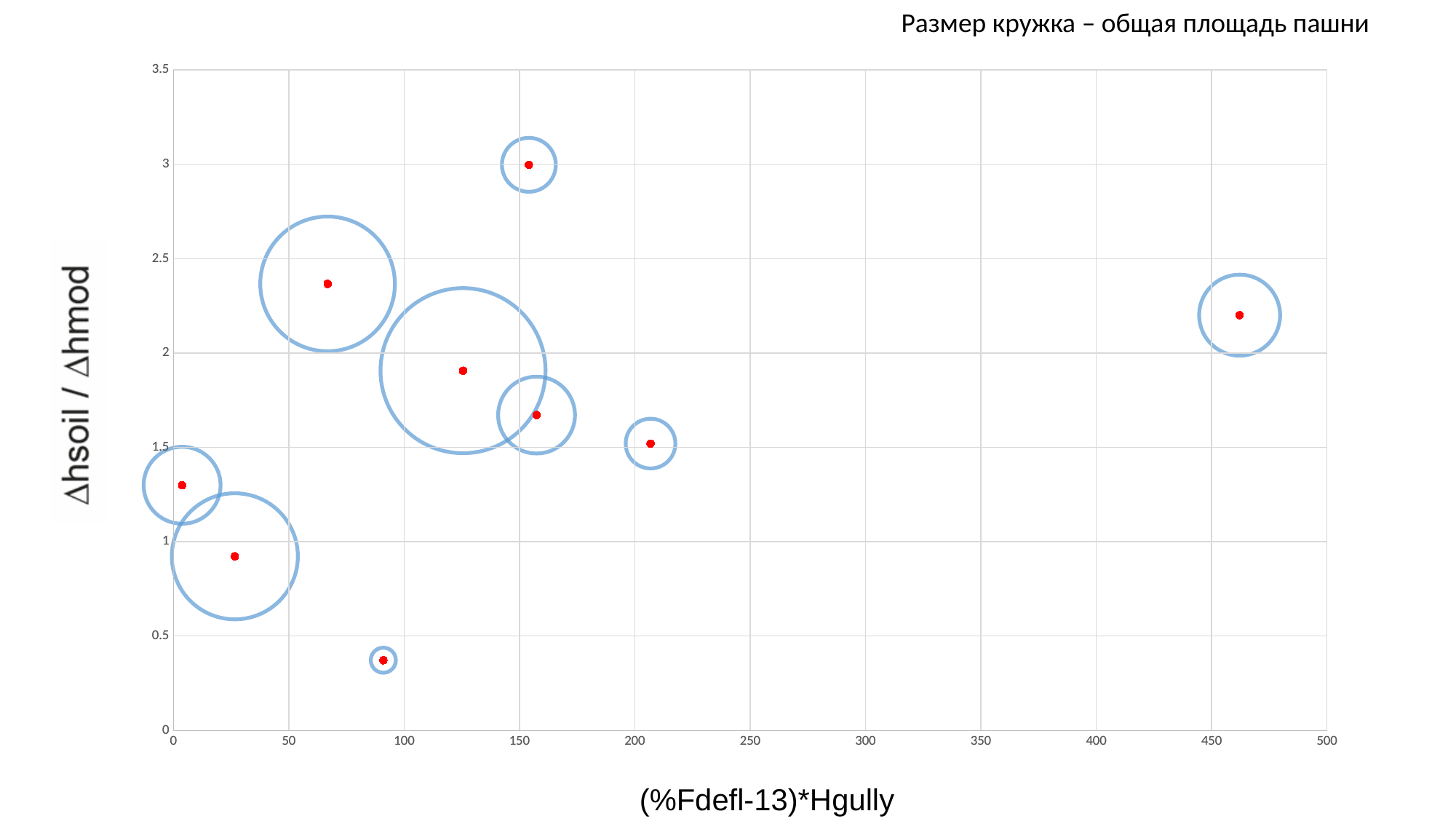
Is the (%Fdefl-13)*Hgully value of the rightmost bubble greater or less than 450? greater Is the Δhsoil / Δhmod value of the lowest bubble greater or less than 0.5? less Is the Δhsoil / Δhmod value of the largest bubble greater or less than 2? less What is the label of the vertical axis? Δhsoil / Δhmod Which has a higher Δhsoil / Δhmod value: the bubble near x=150 at the top of the chart or the bubble near x=460? the bubble near x=150 What kind of chart is shown on the slide? bubble chart What is the label of the horizontal axis? (%Fdefl-13)*Hgully How many bubbles are plotted on the chart? 9 What is the highest tick value shown on the vertical axis? 3.5